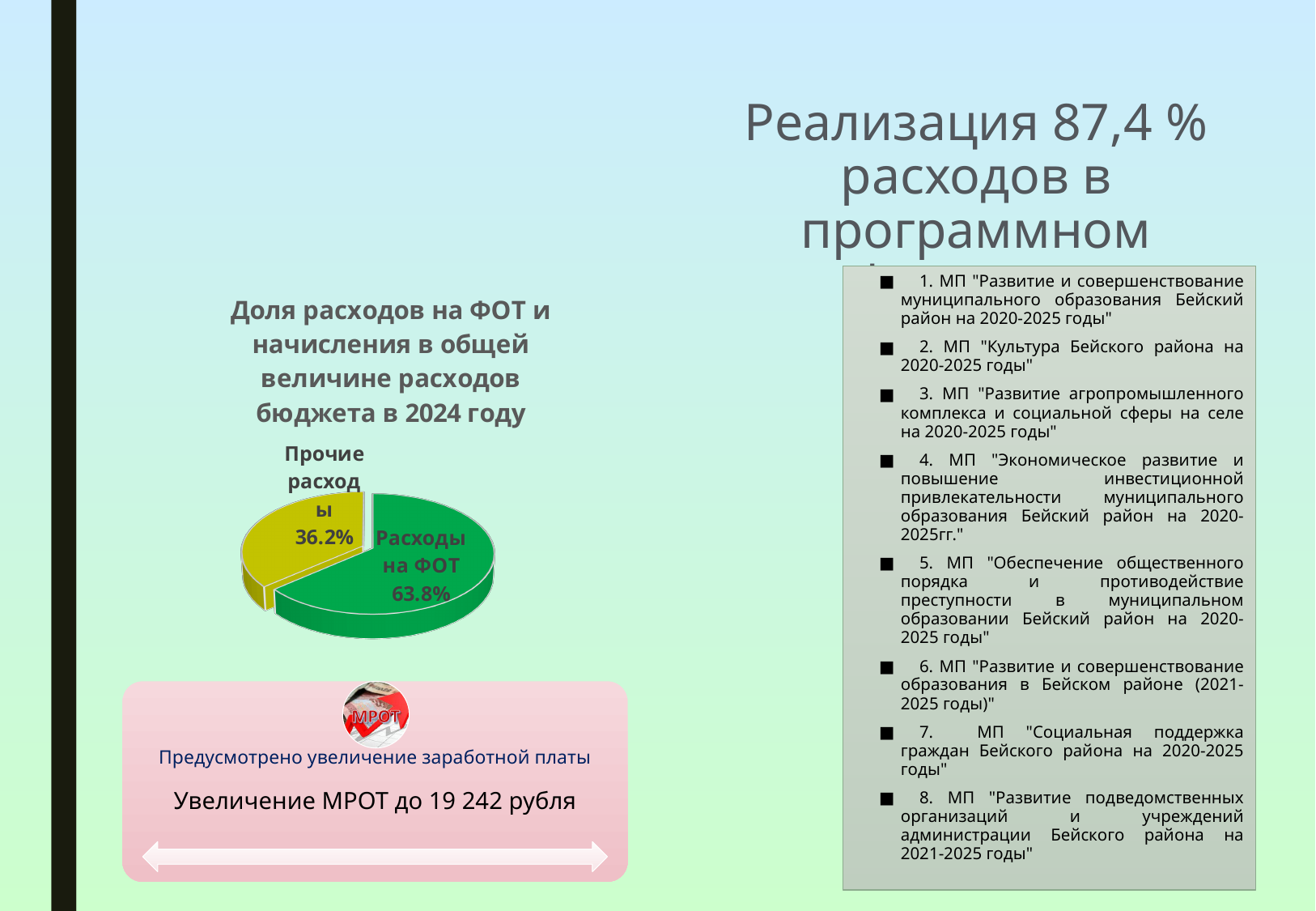
How many slices does the pie chart have? 2 What is the share of "Прочие расходы" in the pie chart? 36.2% What colour is the "Расходы на ФОТ" slice in the pie chart? Green Which is larger in the pie chart: "Расходы на ФОТ" or "Прочие расходы"? Расходы на ФОТ What is the title of the pie chart? Доля расходов на ФОТ и начисления в общей величине расходов бюджета в 2024 году Is the share of "Прочие расходы" greater or less than 50%? less What is the difference in percentage points between "Расходы на ФОТ" and "Прочие расходы"? 27.6 What type of chart is shown on the slide? Pie chart What is the share of "Расходы на ФОТ" in the pie chart? 63.8% Which slice of the pie chart is the smallest? Прочие расходы Which slice of the pie chart is the largest? Расходы на ФОТ